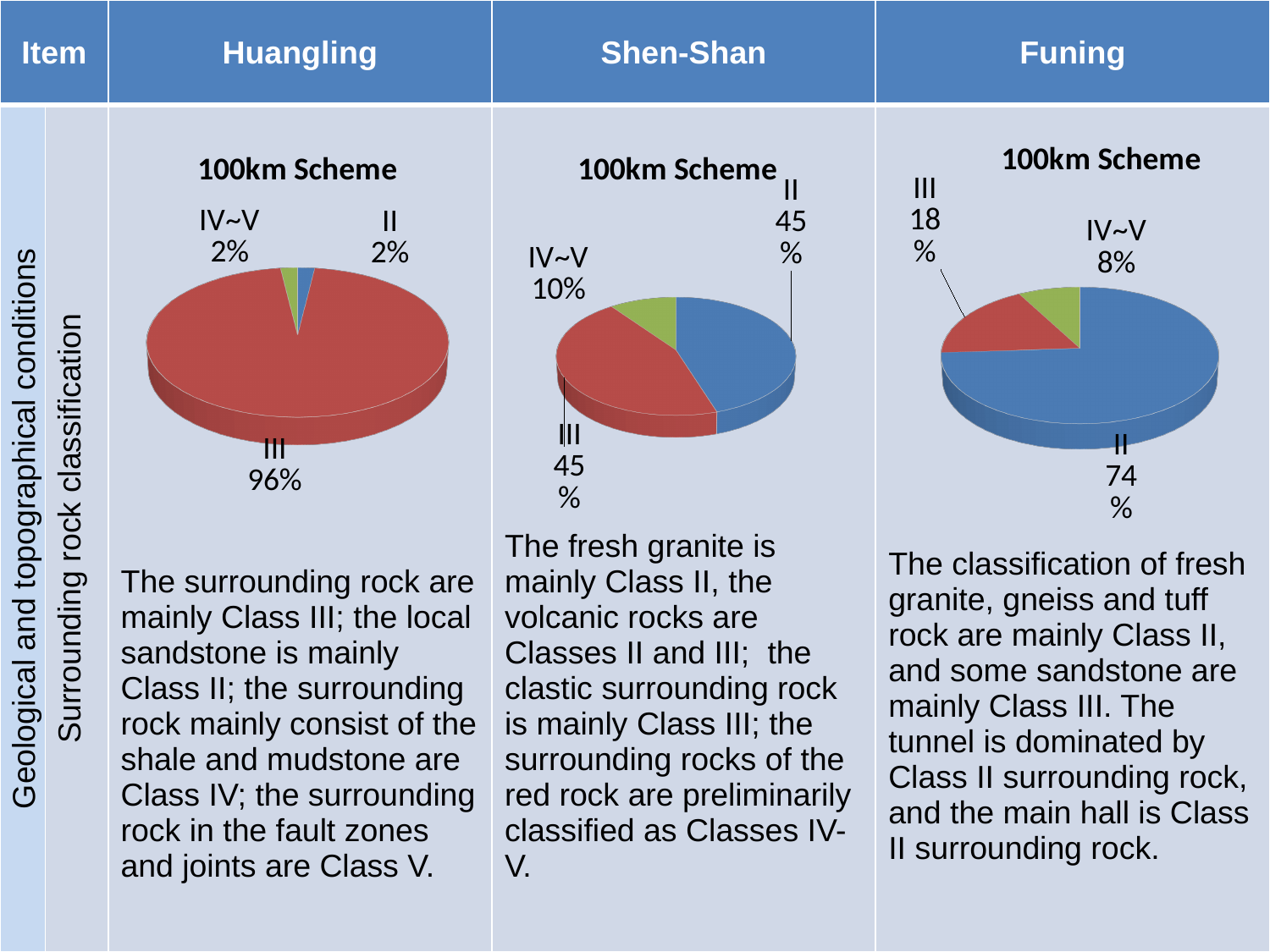
What type of chart is used in the Funing column? Pie chart In the Shen-Shan pie chart, what share does Class IV~V have? 10% In the Funing pie chart, what is the difference between the Class II share and the Class III share? 56% In the Shen-Shan pie chart, what share does Class II have? 45% In the Funing pie chart, what share does Class II have? 74% In the Funing pie chart, what share does Class III have? 18% How many slices does the Shen-Shan pie chart have? 3 In the Huangling pie chart, what share does Class II have? 2% In the Funing pie chart, which class has the smallest share? IV~V In the Huangling pie chart, what share does Class III have? 96% In the Shen-Shan pie chart, is the Class III share larger or smaller than the Class IV~V share? larger In the Huangling pie chart, which class has the largest share? III